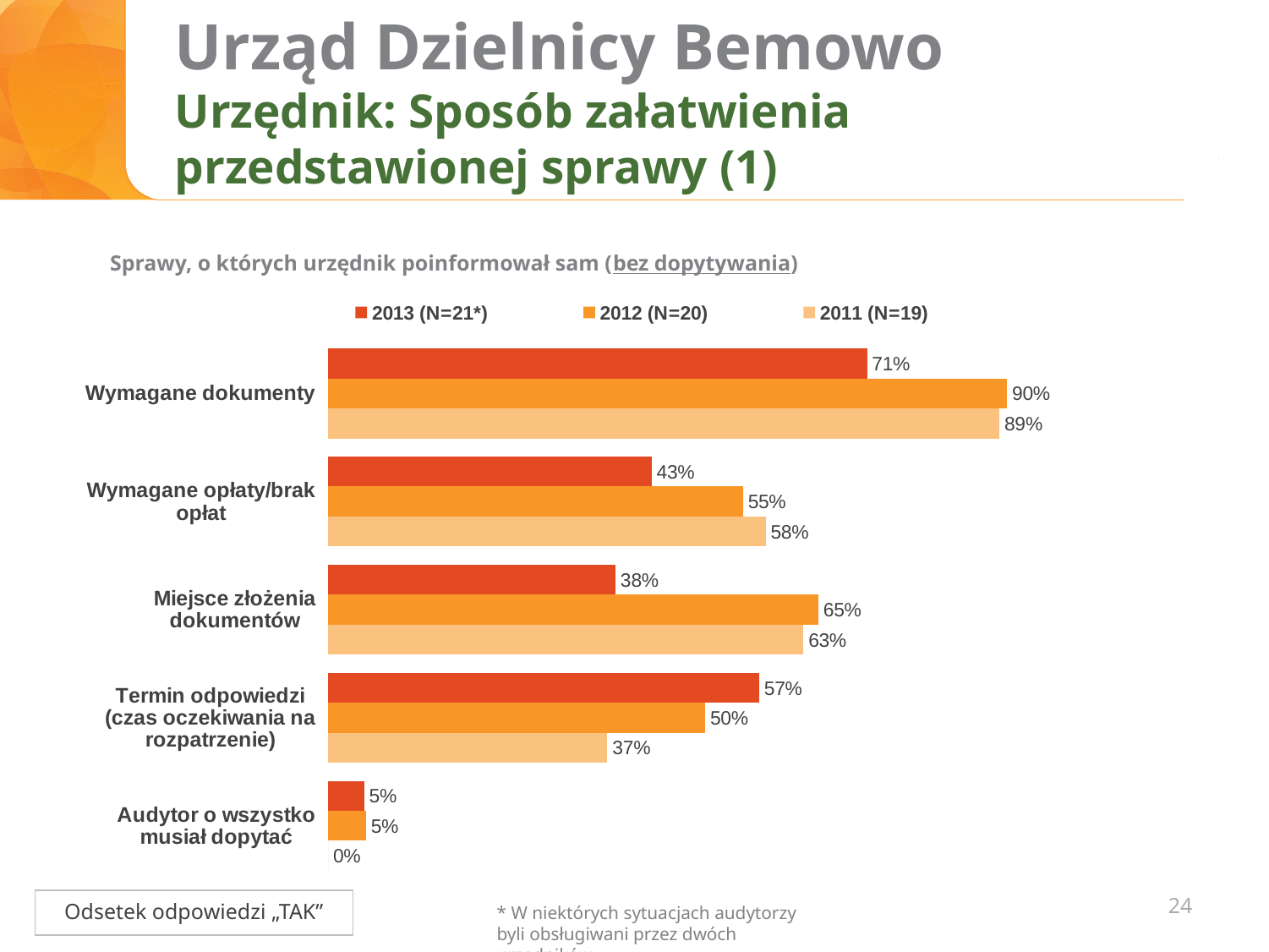
What is the difference between the 2011 (N=19) and 2013 (N=21*) values for Wymagane opłaty/brak opłat? 15 percentage points What is the value for Miejsce złożenia dokumentów in the 2012 (N=20) series? 65% How many categories are shown on the chart? 5 What kind of chart is shown on the slide? Bar chart Which is larger for Termin odpowiedzi (czas oczekiwania na rozpatrzenie): the 2013 (N=21*) value or the 2011 (N=19) value? 2013 (N=21*) Which category has the highest value in the 2012 (N=20) series? Wymagane dokumenty What is the value for Termin odpowiedzi (czas oczekiwania na rozpatrzenie) in the 2011 (N=19) series? 37% How many series does the legend list? 3 Which category has the lowest value in the 2011 (N=19) series? Audytor o wszystko musiał dopytać What is the value for Wymagane dokumenty in the 2013 (N=21*) series? 71% What is the difference between the 2012 (N=20) and 2013 (N=21*) values for Wymagane dokumenty? 19 percentage points What is the title of the chart? Sprawy, o których urzędnik poinformował sam (bez dopytywania)